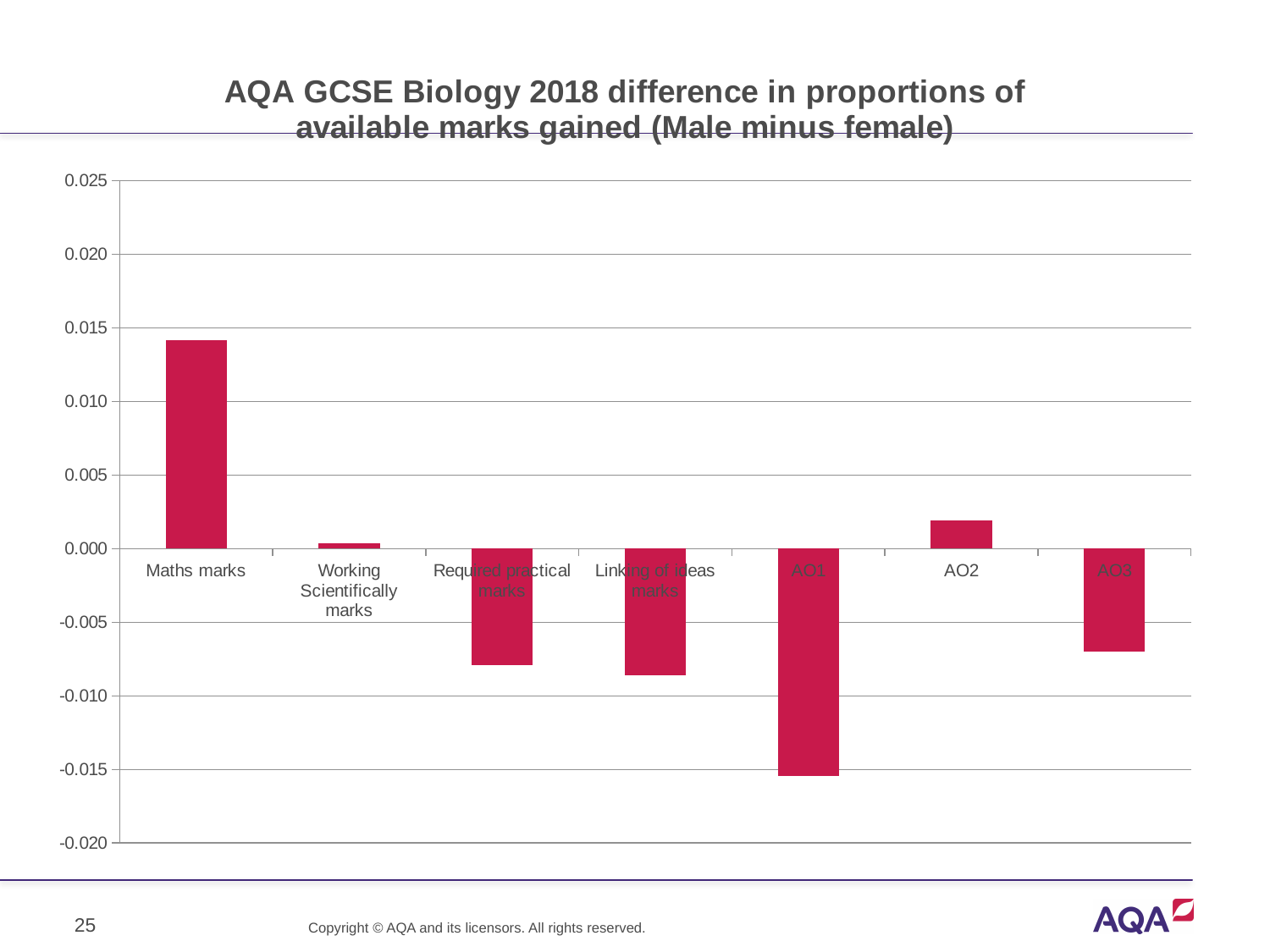
Is the value for Maths marks greater or less than 0.010? greater What kind of chart is shown on the slide? bar chart Is the value for AO2 greater or less than 0.005? less Is the value for AO3 greater or less than -0.010? greater Which is larger, the value for Maths marks or the value for AO2? Maths marks Which category has the lowest value? AO1 How many categories are plotted on the chart? 7 Which category has the highest value? Maths marks Which is larger, the value for AO3 or the value for AO1? AO3 What is the title of the chart? AQA GCSE Biology 2018 difference in proportions of available marks gained (Male minus female)